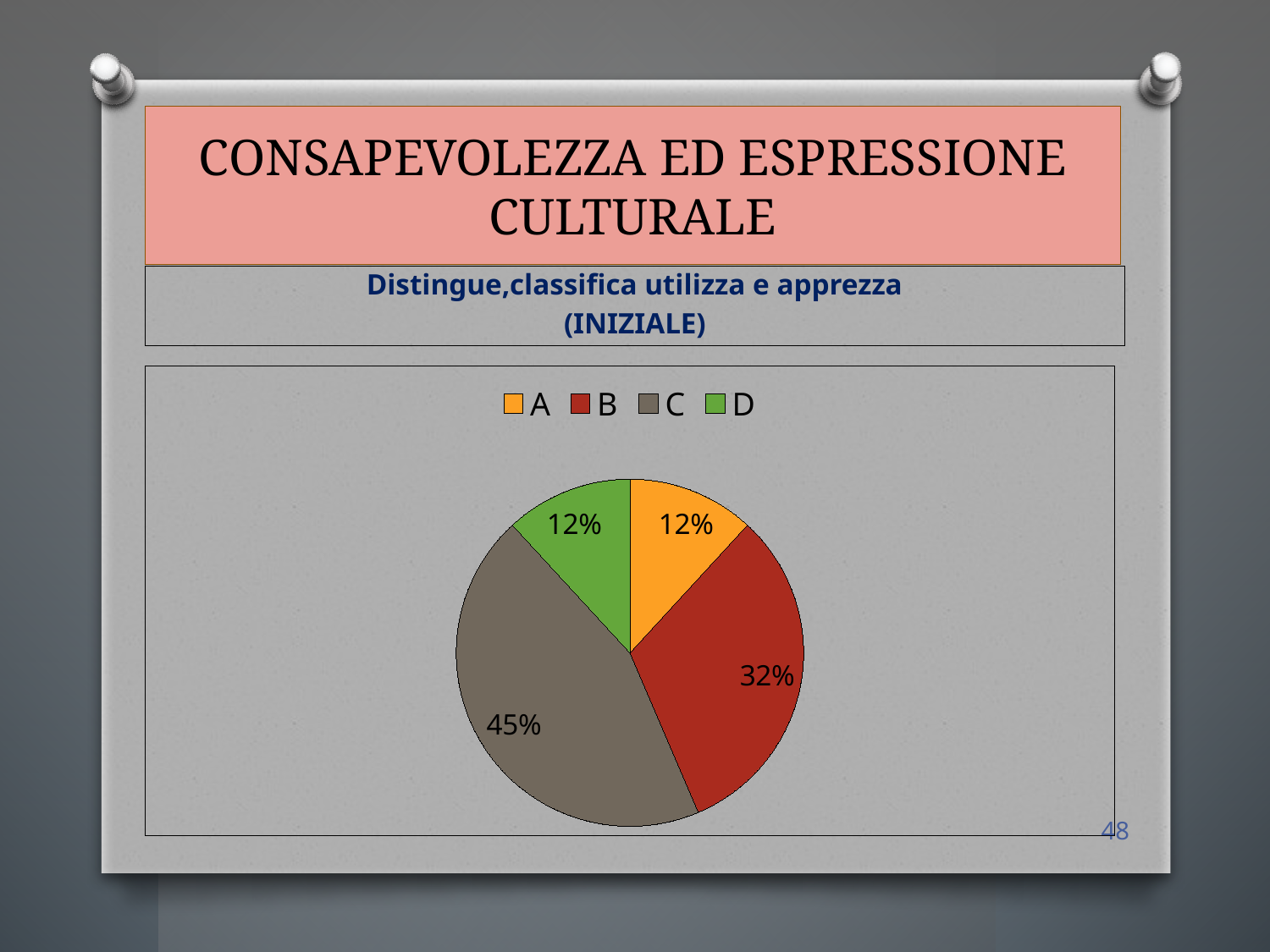
How many entries does the legend list? 4 What kind of chart is shown on the slide? pie chart What share of the pie does category C have? 45% How many slices does the pie chart have? 4 What share of the pie does category D have? 12% Which category has the largest slice of the pie? C What colour is the slice for category C? grey What is the combined share of categories A and D? 24% What share of the pie does category B have? 32% Which is larger, the slice for B or the slice for D? B What is the difference in percentage points between category C and category B? 13